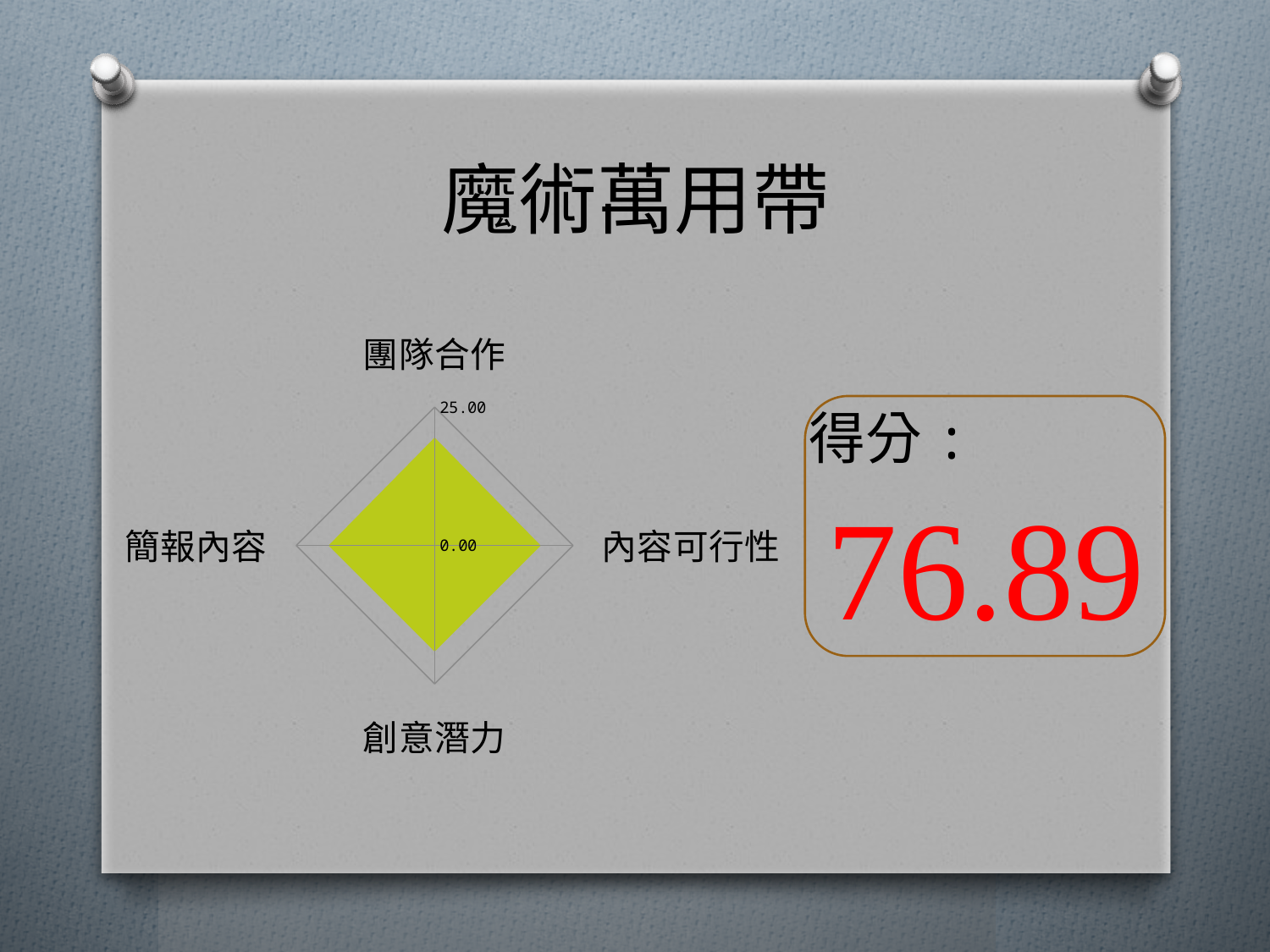
Is the value for 簡報內容 greater or less than 25.00? less What is the minimum value shown on the radar chart's axis scale? 0.00 How many categories (axes) does the radar chart have? 4 Which category label appears at the bottom of the radar chart? 創意潛力 What kind of chart is shown on the slide? radar chart Which category label appears at the top of the radar chart? 團隊合作 Is the value for 內容可行性 greater or less than 25.00? less Is the value for 創意潛力 greater or less than 25.00? less